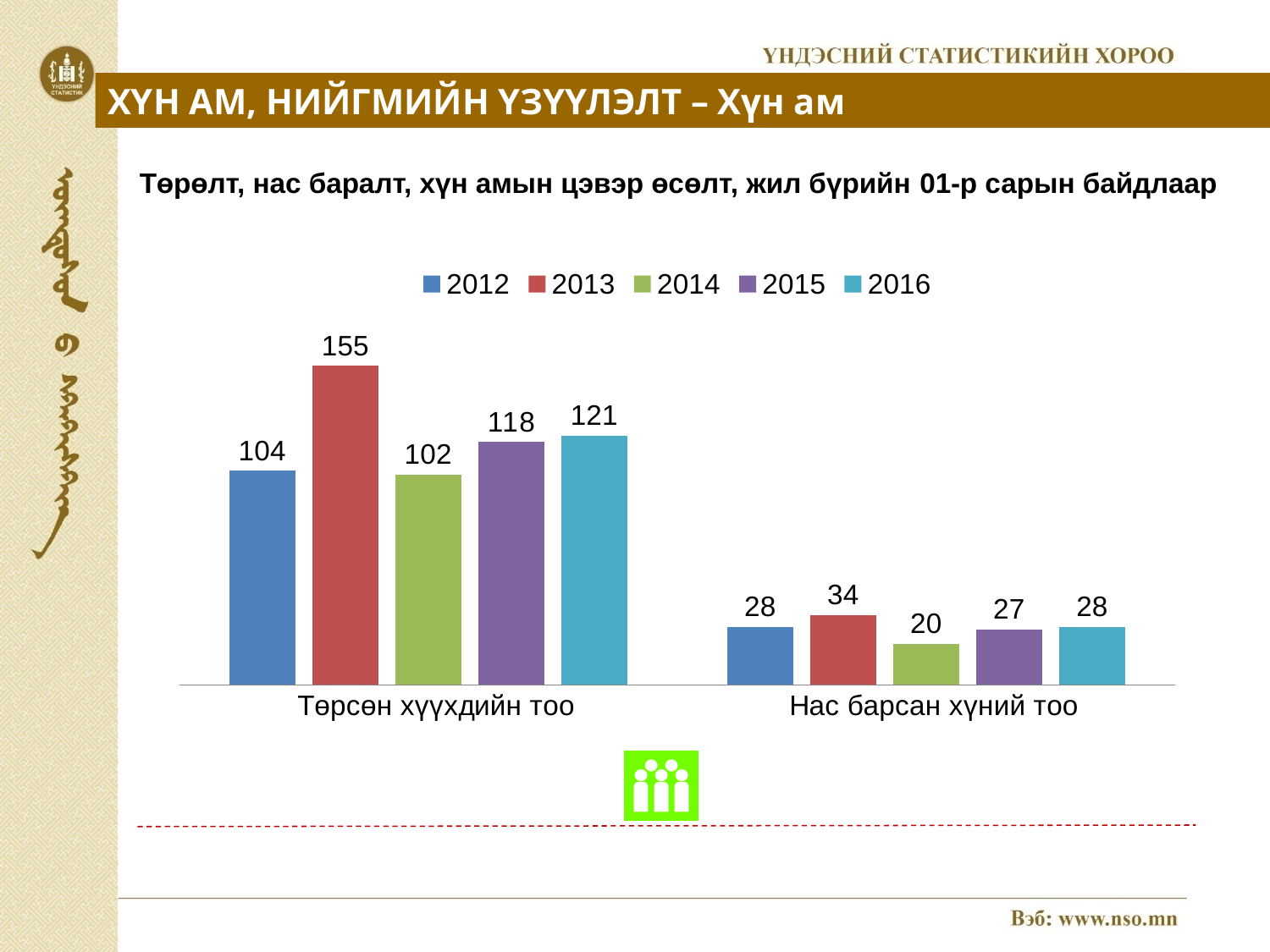
Which year has the highest value for "Төрсөн хүүхдийн тоо"? 2013 How many categories are shown on the x axis? 2 Which is larger for "Төрсөн хүүхдийн тоо": the 2015 value or the 2016 value? 2016 What type of chart is shown on the slide? bar chart What is the value for 2016 in the "Төрсөн хүүхдийн тоо" category? 121 What is the value for 2013 in the "Төрсөн хүүхдийн тоо" category? 155 What is the difference between the 2013 and 2014 values for "Нас барсан хүний тоо"? 14 Which year has the lowest value for "Нас барсан хүний тоо"? 2014 Which year is shown in red in the legend? 2013 What is the value for 2014 in the "Нас барсан хүний тоо" category? 20 What is the difference between the 2013 and 2012 values for "Төрсөн хүүхдийн тоо"? 51 How many series does the legend list? 5